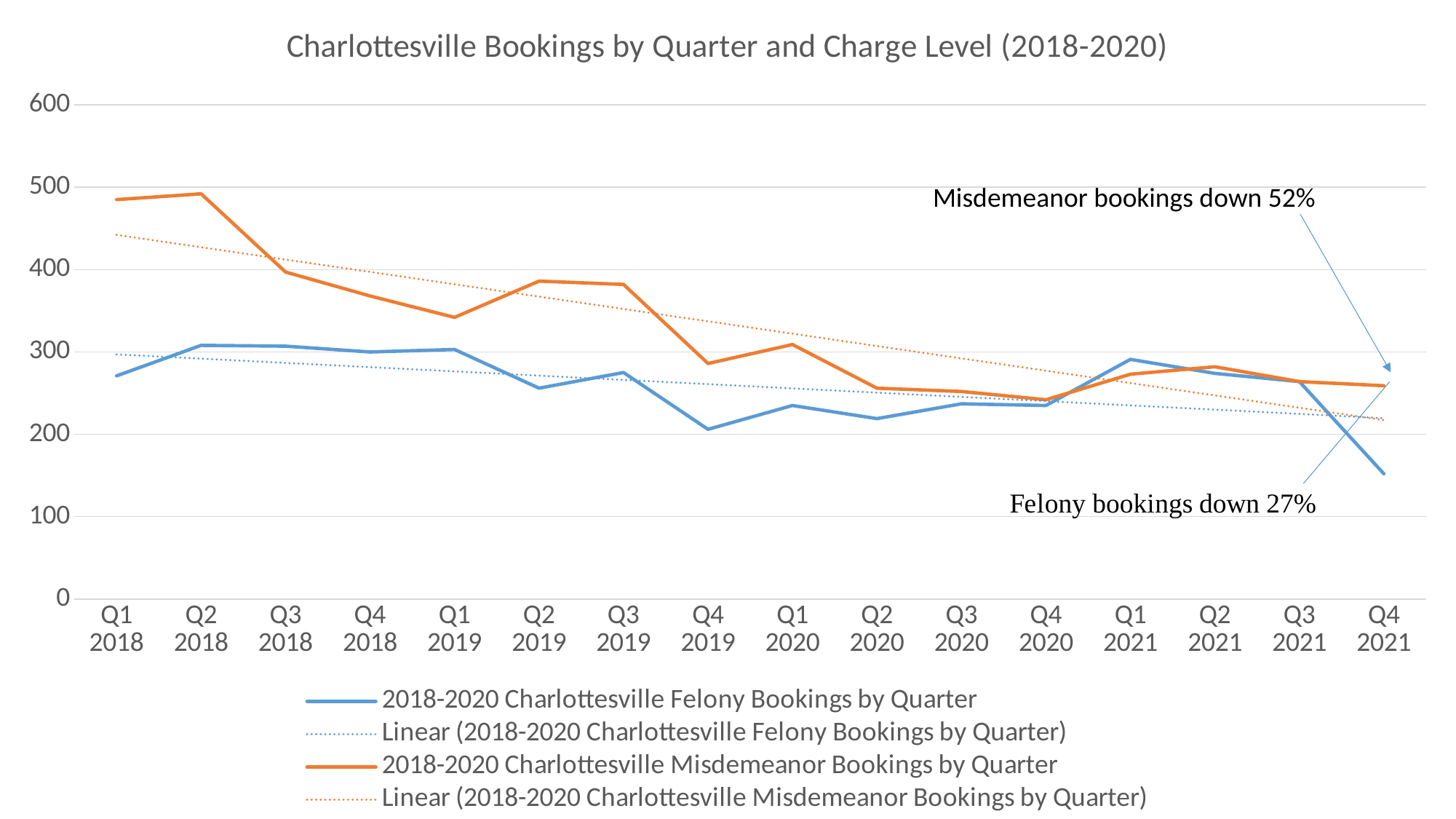
What type of chart is shown on the slide? Line chart Do Misdemeanor Bookings generally rise or fall from Q1 2018 to Q4 2021? Fall In Q1 2018, which is larger: Felony Bookings or Misdemeanor Bookings? Misdemeanor Bookings What is the title of the chart? Charlottesville Bookings by Quarter and Charge Level (2018-2020) How many series does the legend list? 4 Is the value for Felony Bookings in Q4 2021 greater or less than 200? less Is the value for Misdemeanor Bookings in Q4 2019 greater or less than 300? less Is the value for Misdemeanor Bookings in Q1 2019 greater or less than 300? greater How many quarters are plotted along the x axis? 16 According to the annotation on the chart, by what percentage are misdemeanor bookings down? 52% In which quarter is the Felony Bookings line at its lowest? Q4 2021